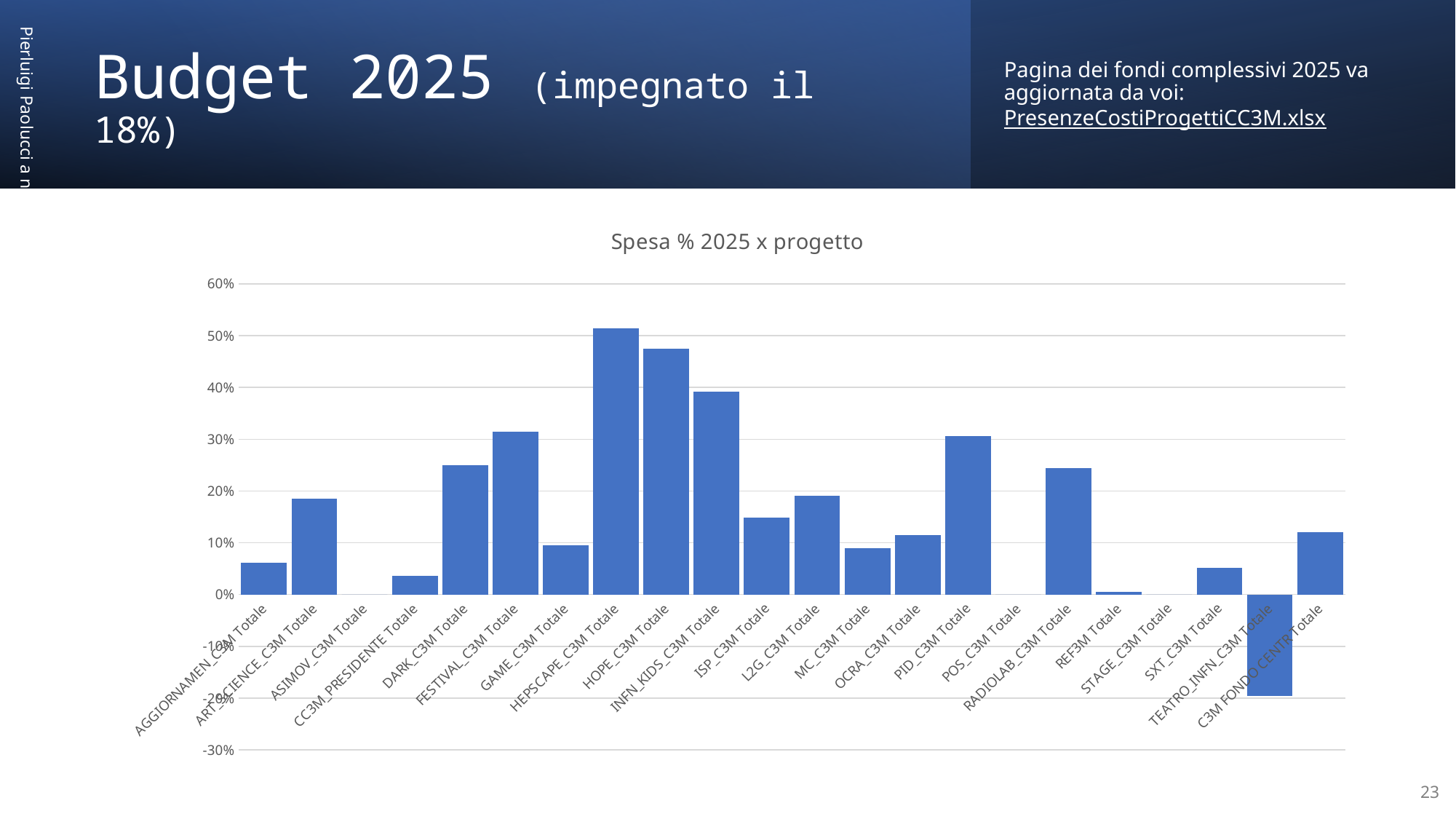
Is the value for TEATRO_INFN_C3M Totale greater or less than 0%? less How many project categories are shown on the x axis of the chart? 22 What is the title of the chart? Spesa % 2025 x progetto Is the value for ISP_C3M Totale greater or less than 10%? greater Which is larger, the value for HOPE_C3M Totale or the value for INFN_KIDS_C3M Totale? HOPE_C3M Totale Which is larger, the value for DARK_C3M Totale or the value for GAME_C3M Totale? DARK_C3M Totale Is the value for HOPE_C3M Totale greater or less than 50%? less Which project has the highest value in the chart? HEPSCAPE_C3M Totale What type of chart is shown on the slide? bar chart Which project has the lowest value in the chart? TEATRO_INFN_C3M Totale